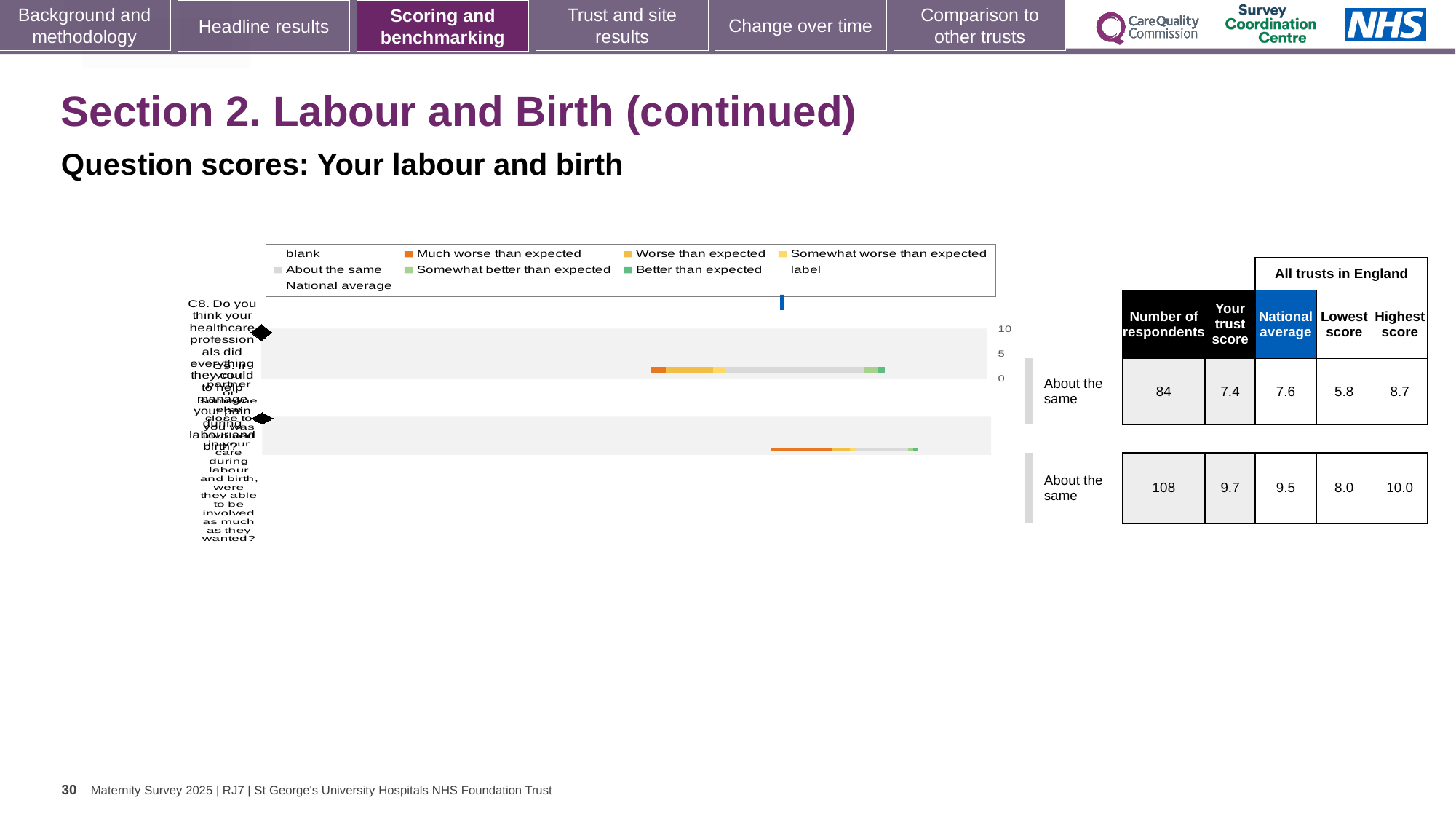
For question C8 (first row), which is larger: the trust's score or the national average? National average In the table next to the chart, how many respondents answered question C8 (the first row)? 84 What is the highest score across all trusts in England for the second row of the table? 10.0 What benchmark category is shown for both questions on this slide? About the same How many questions are plotted in the chart on this slide? 2 For the second row of the table, what is the difference between the highest score and the lowest score across all trusts in England? 2.0 For question C8 (first row), what is the difference between the highest score and the lowest score across all trusts in England? 2.9 What is the national average for question C8 (the first row of the table)? 7.6 For the second row of the table, which is larger: the trust's score or the national average? Your trust score What is the trust's score for question C8 (the first row of the table)? 7.4 What is the number of respondents shown in the second row of the table? 108 What is the lowest score across all trusts in England for the second row of the table? 8.0